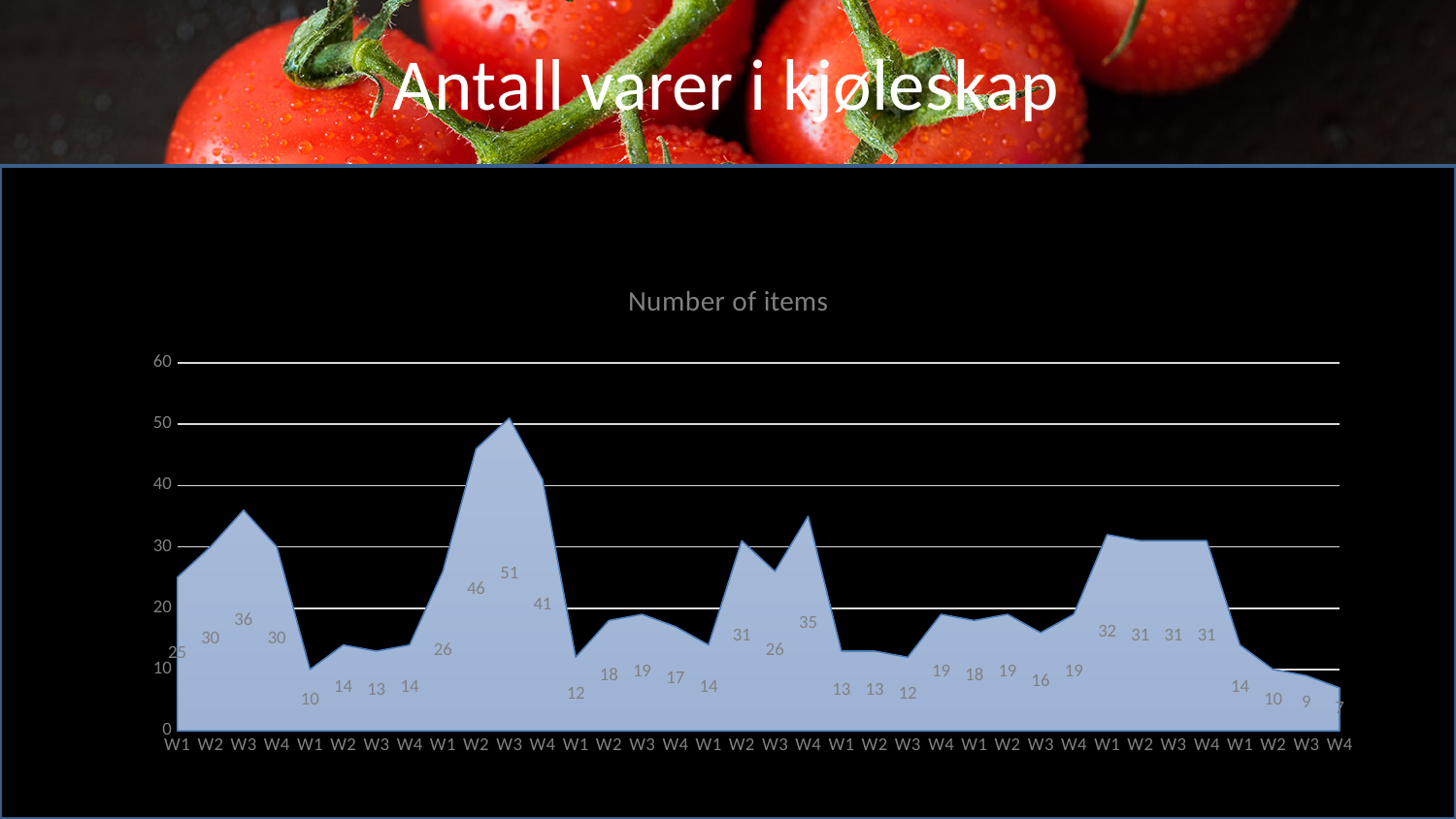
Do the values rise or fall over the last four data points of the chart? fall Which is larger: the value 46 just before the peak or the value 41 just after the peak? 46 What is the difference between the peak value of 51 and the value of 46 immediately before it? 5 What is the title of the chart? Number of items Is the peak value of the chart greater or less than 40? greater Do the values rise or fall over the first three data points of the chart? rise What is the highest value plotted in the chart? 51 What is the title of the slide? Antall varer i kjøleskap What kind of chart is shown on the slide? area chart What is the value of the third data point (the first W3) in the chart? 36 What is the value of the first data point (the first W1) in the chart? 25 How many data points are plotted in the chart? 36